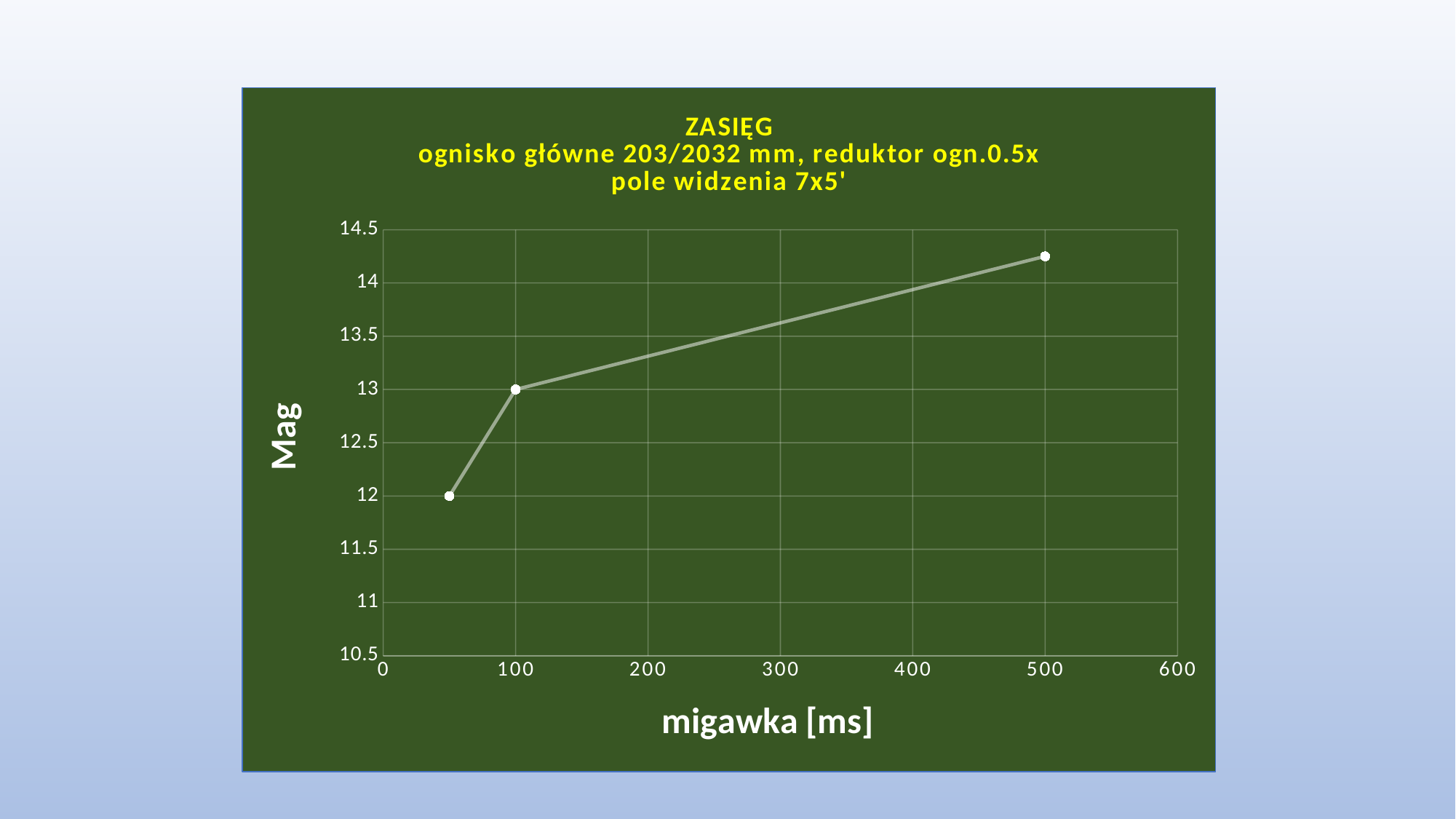
Is the Mag value at 500 ms greater or less than 14.5? less What is the label of the x axis? migawka [ms] What is the Mag value of the leftmost data point? 12 What is the Mag value at a shutter (migawka) of 100 ms? 13 What is the first line of the chart title? ZASIĘG How many data points are plotted on the line? 3 Which data point has the lowest Mag value? the leftmost point (12) What kind of chart is shown on the slide? line chart Which has the higher Mag value: the point at 100 ms or the point at 500 ms? 500 ms What is the difference in Mag between the point at 100 ms and the leftmost point? 1 Is the Mag value at 500 ms greater or less than 14? greater Do the Mag values rise or fall as the shutter time (migawka) increases? rise